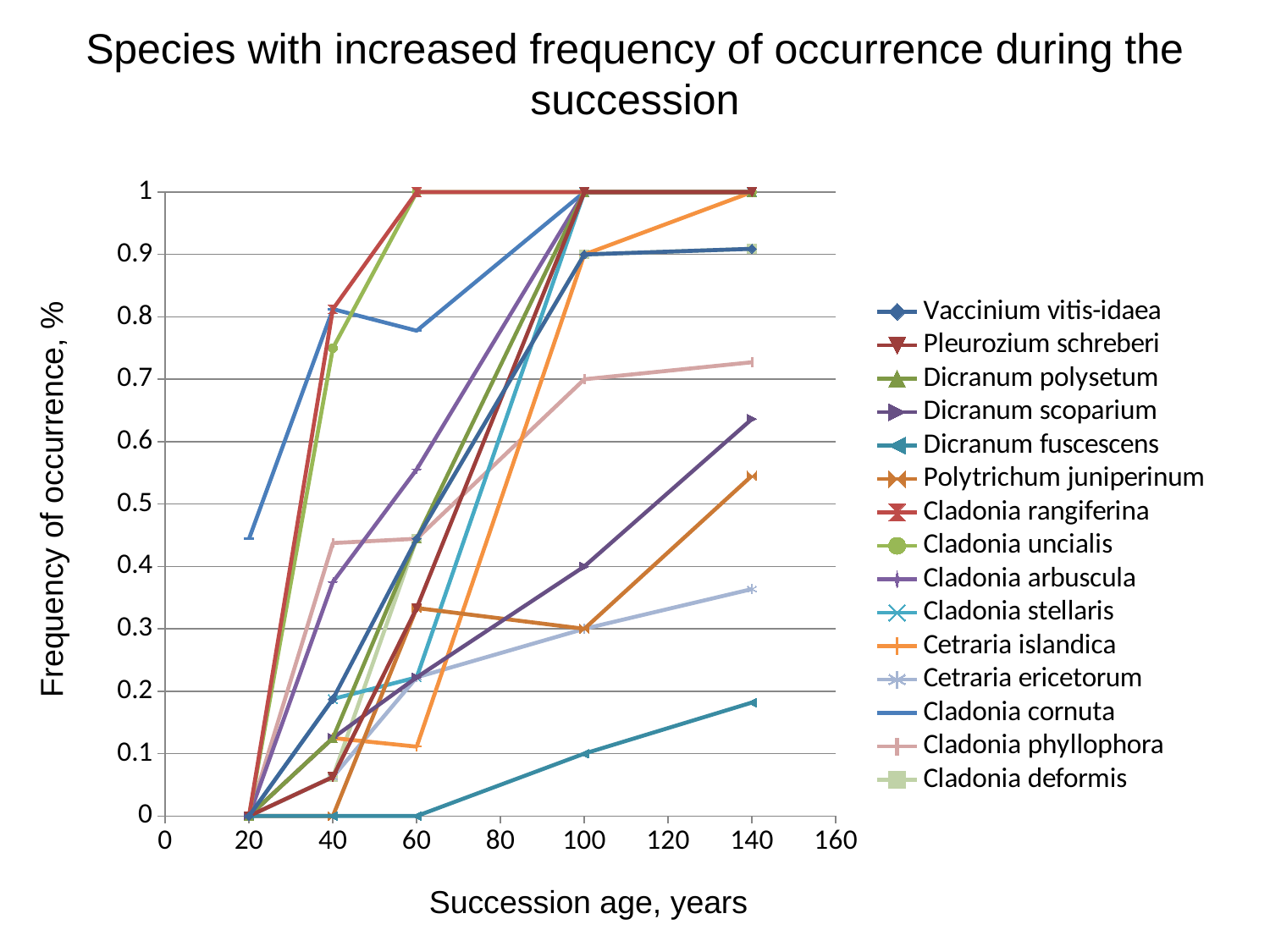
What is the frequency of occurrence for Dicranum fuscescens at succession age 60 years? 0 Which species has the lowest frequency of occurrence at succession age 140 years? Dicranum fuscescens At 140 years, which is larger: the value for Cladonia phyllophora or the value for Cetraria ericetorum? Cladonia phyllophora How many species does the legend list? 15 Does the frequency of occurrence for Dicranum fuscescens rise or fall as succession age increases from 60 to 140 years? rise What is the label of the x axis? Succession age, years What is the frequency of occurrence for Pleurozium schreberi at succession age 140 years? 1 What kind of chart is shown on the slide? line chart Is the value for Cetraria ericetorum at 140 years greater or less than 0.4? less What is the frequency of occurrence for Dicranum fuscescens at succession age 100 years? 0.1 What is the title of the chart? Species with increased frequency of occurrence during the succession What is the frequency of occurrence for Cladonia phyllophora at succession age 100 years? 0.7